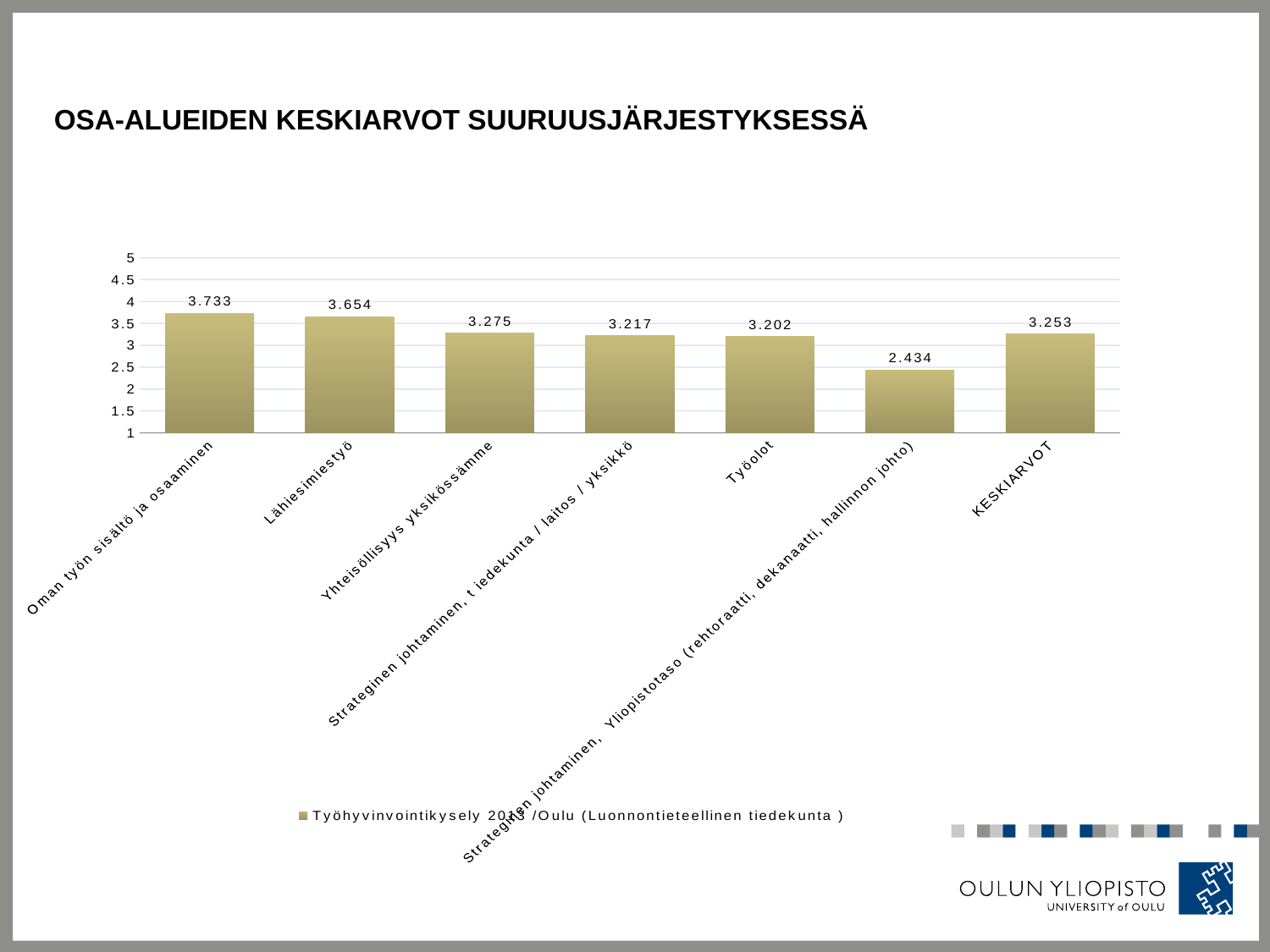
What is the value for KESKIARVOT? 3.253 Is the value for Strateginen johtaminen, Yliopistotaso (rehtoraatti, dekanaatti, hallinnon johto) greater or less than 3? less What is the difference between the values for Oman työn sisältö ja osaaminen and Lähiesimiestyö? 0.079 Which is larger, the value for Yhteisöllisyys yksikössämme or the value for Työolot? Yhteisöllisyys yksikössämme What kind of chart is shown on the slide? bar chart How many bars are shown in the chart? 7 What is the title of the slide? OSA-ALUEIDEN KESKIARVOT SUURUUSJÄRJESTYKSESSÄ Which category has the highest value? Oman työn sisältö ja osaaminen What is the value for Työolot? 3.202 Which category has the lowest value? Strateginen johtaminen, Yliopistotaso (rehtoraatti, dekanaatti, hallinnon johto) What is the value for Lähiesimiestyö? 3.654 What is the value for Oman työn sisältö ja osaaminen? 3.733